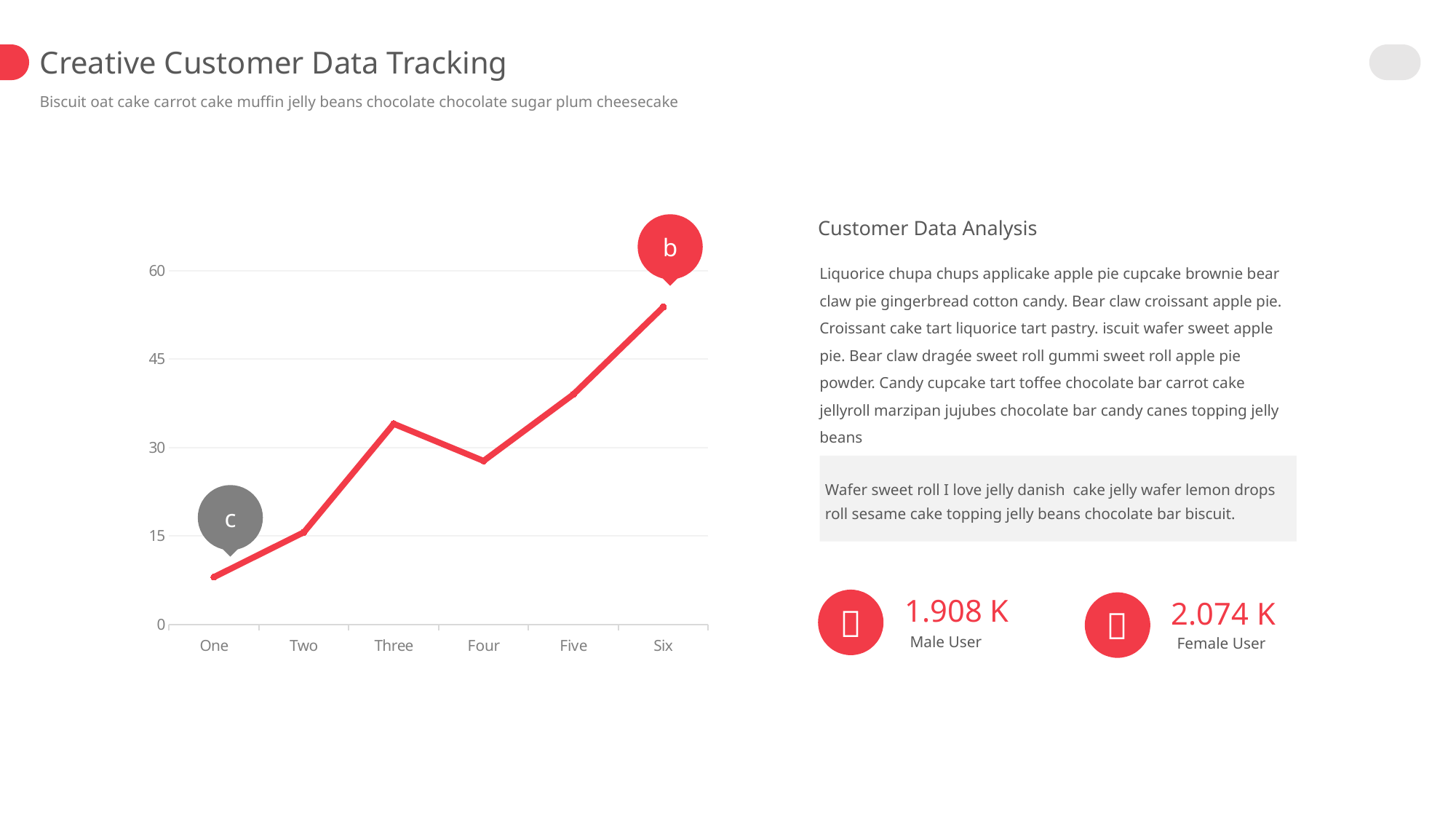
Which category has the lowest value on the chart? One Do the values generally rise or fall from One to Six? Rise Which category has the highest value on the chart? Six Is the value for Four greater or less than 30? less How many categories are shown on the x axis of the chart? 6 Which has the larger value, Three or Four? Three Is the value for One greater or less than 15? less Is the value for Six greater or less than 60? less What colour is the line plotted on the chart? Red What kind of chart is shown on the slide? Line chart